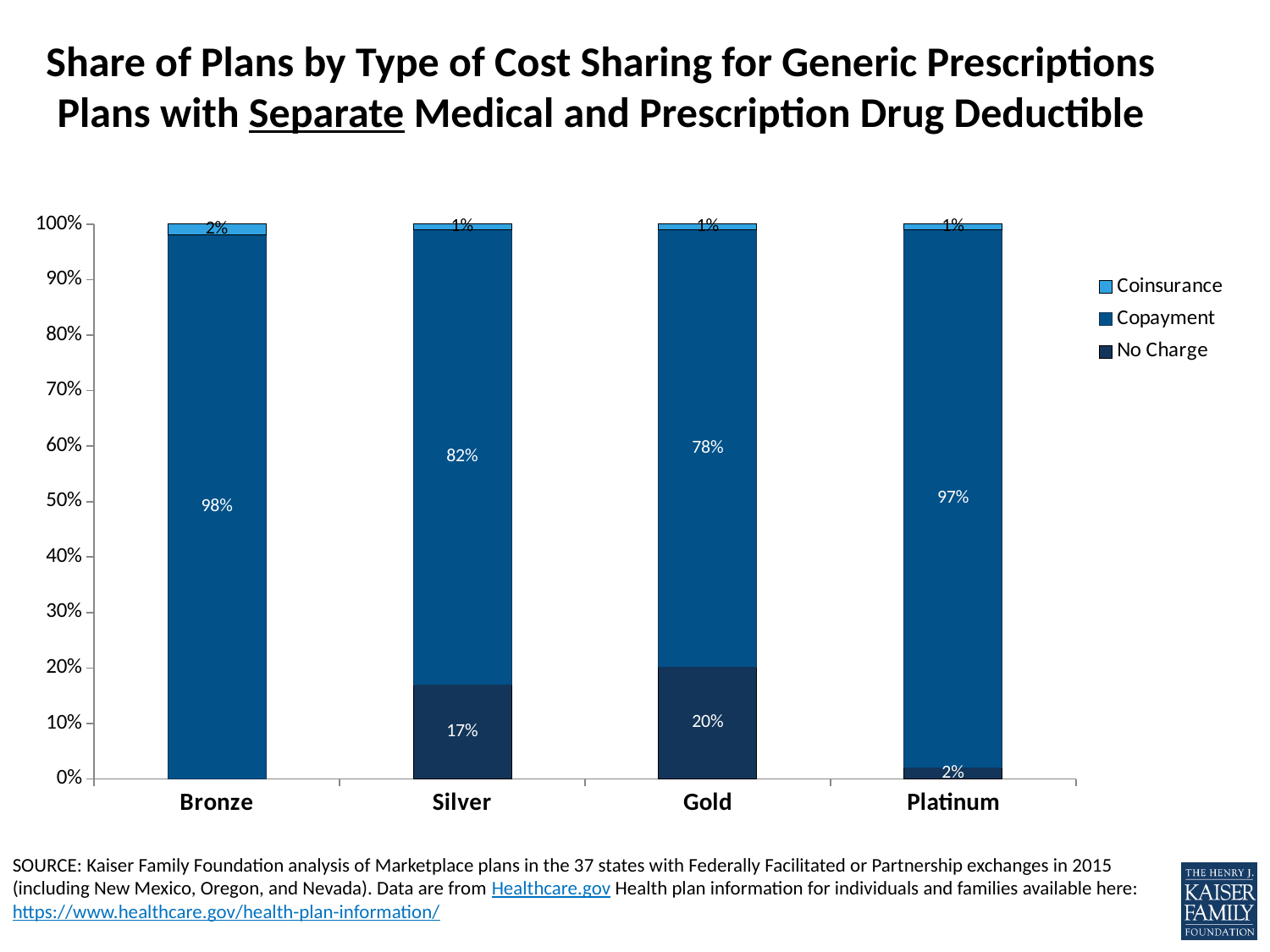
What is the No Charge share for Gold plans? 20% What is the Copayment share for Silver plans? 82% What is the No Charge share for Platinum plans? 2% Which metal level has the highest Copayment share? Bronze How many metal levels are shown on the x axis? 4 What is the Copayment share for Bronze plans? 98% What is the difference between the Copayment share for Platinum and for Gold? 19% Which metal level has the highest No Charge share? Gold What kind of chart is shown on the slide? Stacked bar chart How many series does the legend list? 3 Is the No Charge share larger for Silver or for Gold? Gold What is the Coinsurance share for Bronze plans? 2%